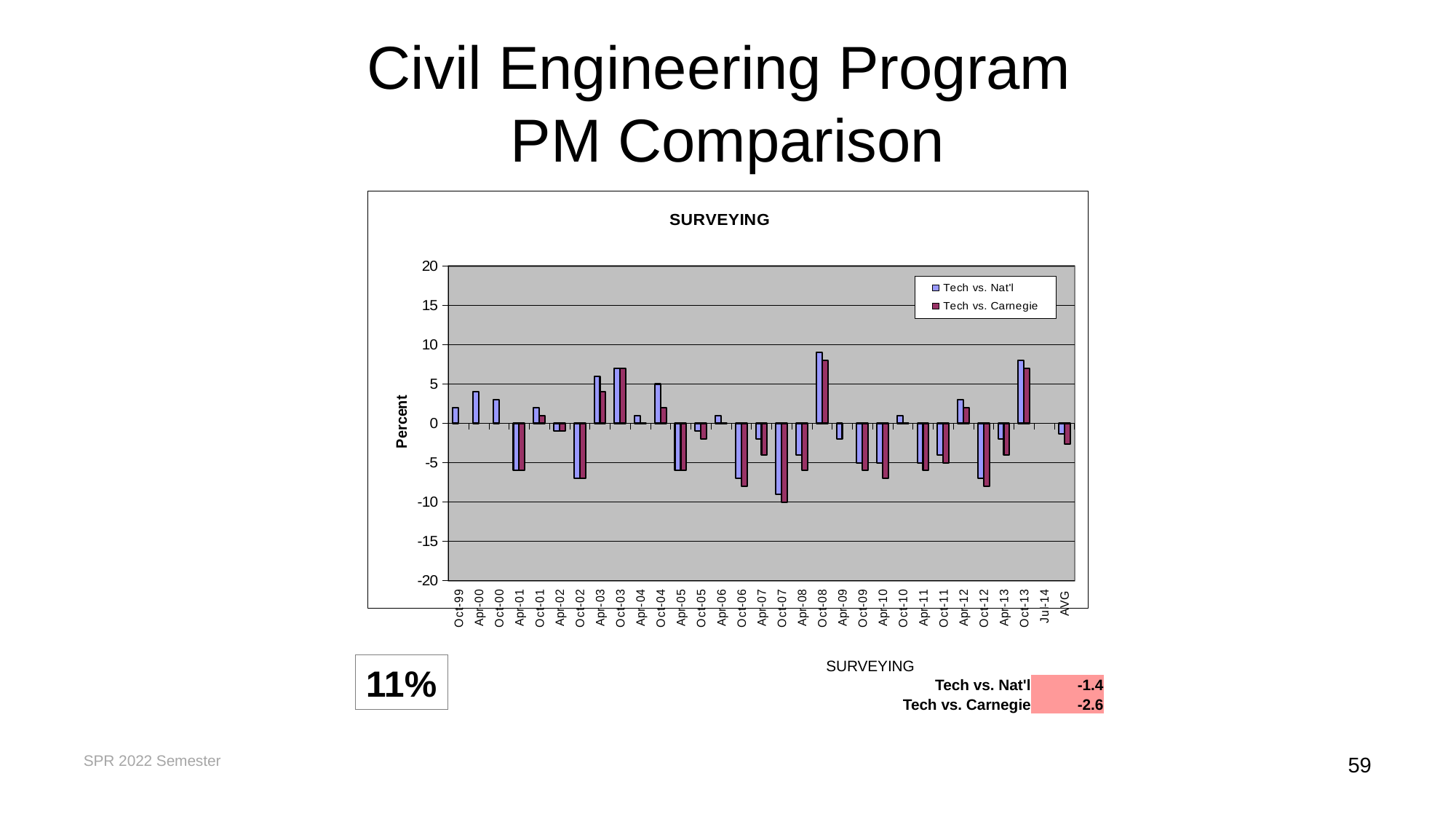
How many categories are shown along the x axis of the chart? 31 What kind of chart is shown on the slide? bar chart What is the label on the vertical axis of the chart? Percent How many series does the legend of the SURVEYING chart list? 2 Which period has the lowest Tech vs. Carnegie value? Oct-07 Is the Tech vs. Nat'l value for Oct-08 greater or less than 5? greater What is the average (AVG) value for Tech vs. Carnegie shown in the table below the chart? -2.6 Is the Tech vs. Carnegie value for Oct-07 greater or less than -5? less What is the difference between the Tech vs. Nat'l average (-1.4) and the Tech vs. Carnegie average (-2.6)? 1.2 What is the average (AVG) value for Tech vs. Nat'l shown in the table below the chart? -1.4 Which is larger, the Tech vs. Nat'l value for Oct-08 or for Apr-09? Oct-08 What is the title of the chart? SURVEYING